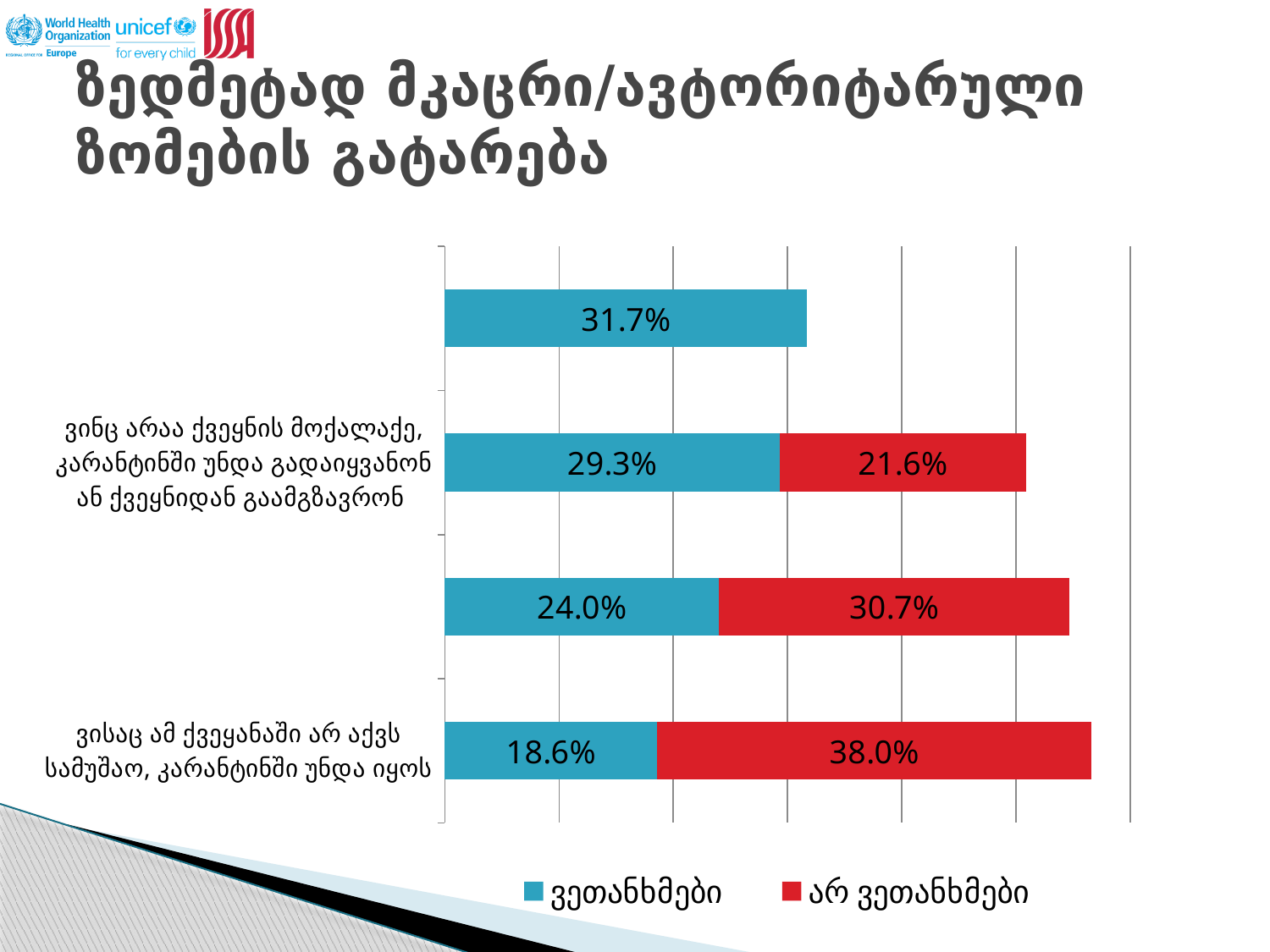
What is the value of ვეთანხმები for "ვინც არაა ქვეყნის მოქალაქე, კარანტინში უნდა გადაიყვანონ ან ქვეყნიდან გაამგზავრონ"? 29.3% What is the total of the stacked bar for "ვინც არაა ქვეყნის მოქალაქე, კარანტინში უნდა გადაიყვანონ ან ქვეყნიდან გაამგზავრონ"? 50.9% What is the value of არ ვეთანხმები for "ვინც არაა ქვეყნის მოქალაქე, კარანტინში უნდა გადაიყვანონ ან ქვეყნიდან გაამგზავრონ"? 21.6% What is the value of ვეთანხმები for "ვისაც ამ ქვეყანაში არ აქვს სამუშაო, კარანტინში უნდა იყოს"? 18.6% What is the difference between არ ვეთანხმები and ვეთანხმები for "ვისაც ამ ქვეყანაში არ აქვს სამუშაო, კარანტინში უნდა იყოს"? 19.4% What kind of chart is shown on the slide? Stacked bar chart What is the total of the stacked bar for "ვისაც ამ ქვეყანაში არ აქვს სამუშაო, კარანტინში უნდა იყოს"? 56.6% For "ვისაც ამ ქვეყანაში არ აქვს სამუშაო, კარანტინში უნდა იყოს", which series has the larger value, ვეთანხმები or არ ვეთანხმები? არ ვეთანხმები What is the difference between ვეთანხმები and არ ვეთანხმები for "ვინც არაა ქვეყნის მოქალაქე, კარანტინში უნდა გადაიყვანონ ან ქვეყნიდან გაამგზავრონ"? 7.7% What is the value of არ ვეთანხმები for "ვისაც ამ ქვეყანაში არ აქვს სამუშაო, კარანტინში უნდა იყოს"? 38.0% What colour represents ვეთანხმები in the chart? Blue How many series does the legend list? 2